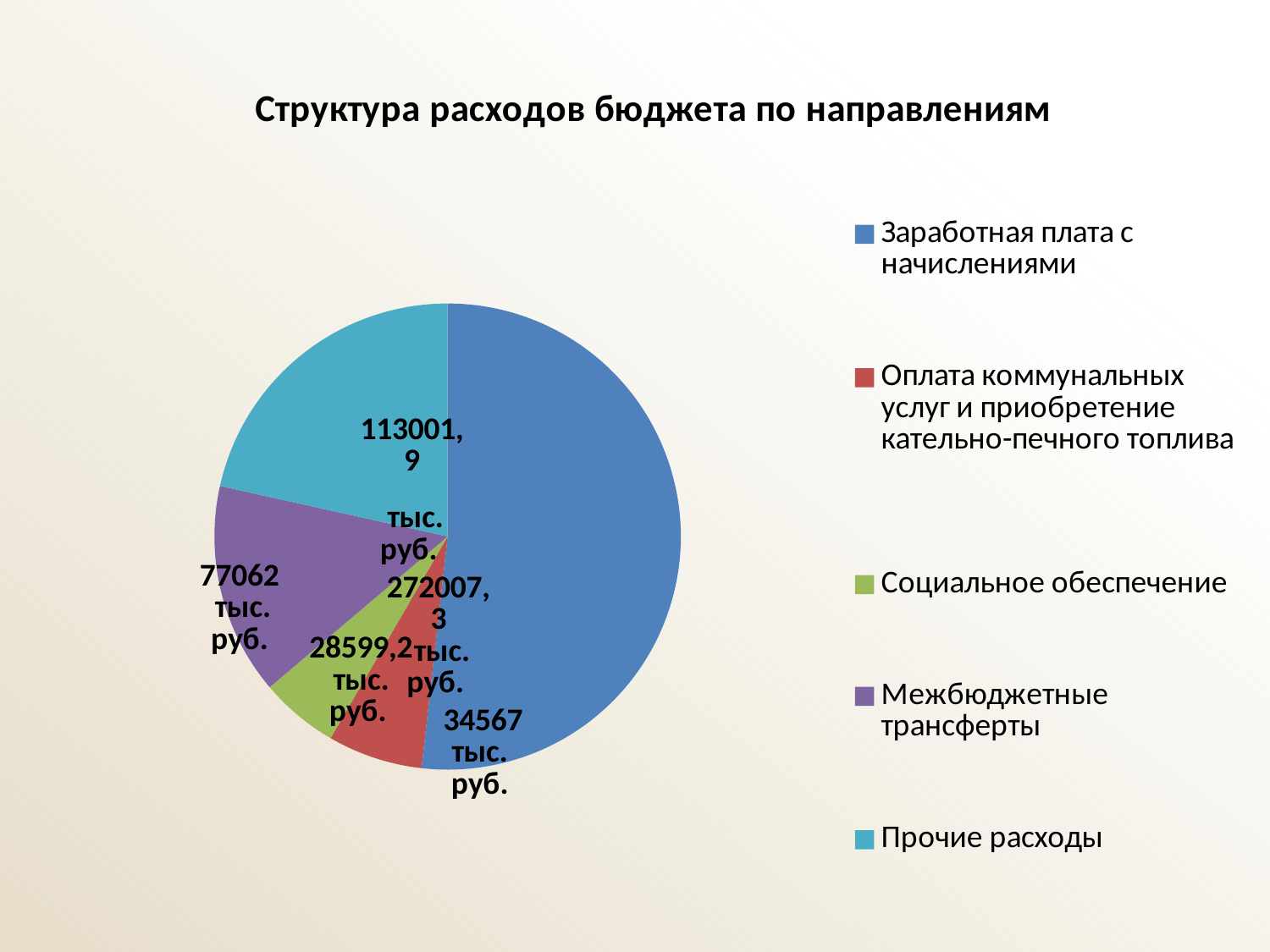
Which category has the largest slice of the pie? Заработная плата с начислениями What type of chart is shown on the slide? pie chart What is the value for Прочие расходы? 113001,9 тыс. руб. What is the title of the chart? Структура расходов бюджета по направлениям What is the value for Межбюджетные трансферты? 77062 тыс. руб. What is the value for Заработная плата с начислениями? 272007,3 тыс. руб. What is the value for Социальное обеспечение? 28599,2 тыс. руб. Which category has the smallest slice of the pie? Социальное обеспечение Which colour represents Оплата коммунальных услуг и приобретение кательно-печного топлива? red How many categories does the legend list? 5 Which is larger: Прочие расходы or Межбюджетные трансферты? Прочие расходы What is the difference between Прочие расходы and Межбюджетные трансферты? 35939,9 тыс. руб.